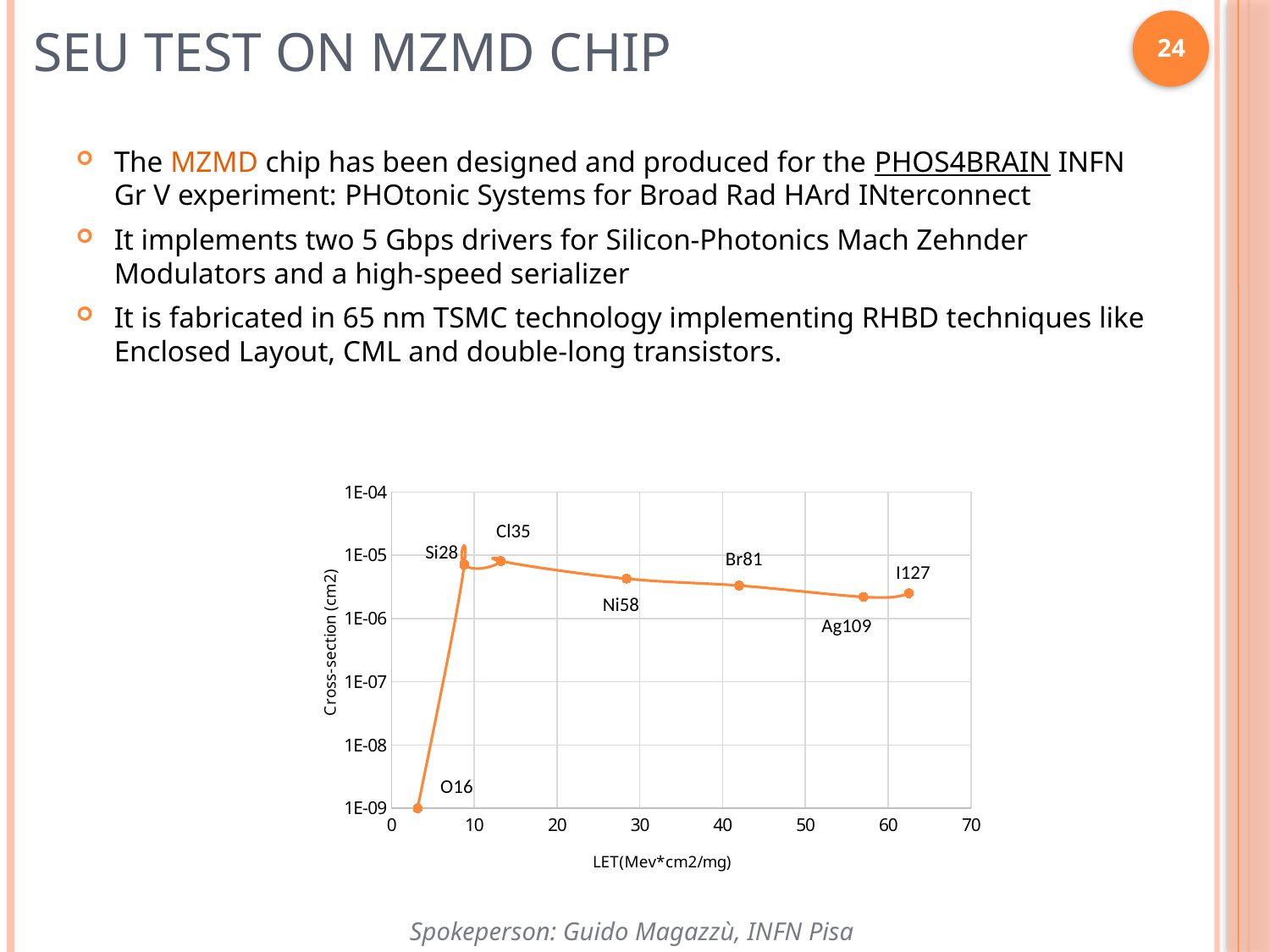
Which ion has the lowest cross-section on the chart? O16 What kind of chart is shown on the slide? line chart From Cl35 to Ag109, does the cross-section rise or fall as LET increases? fall Which has the larger cross-section, Br81 or Ag109? Br81 What is the label of the y axis of the chart? Cross-section (cm2) Which ion is plotted at the highest LET value on the chart? I127 Which has the larger cross-section, Cl35 or Ni58? Cl35 Is the cross-section for O16 greater or less than 1E-08? less How many labelled data points are plotted on the chart? 7 Is the cross-section for Ag109 greater or less than 1E-06? greater Is the cross-section for Ni58 greater or less than 1E-06? greater